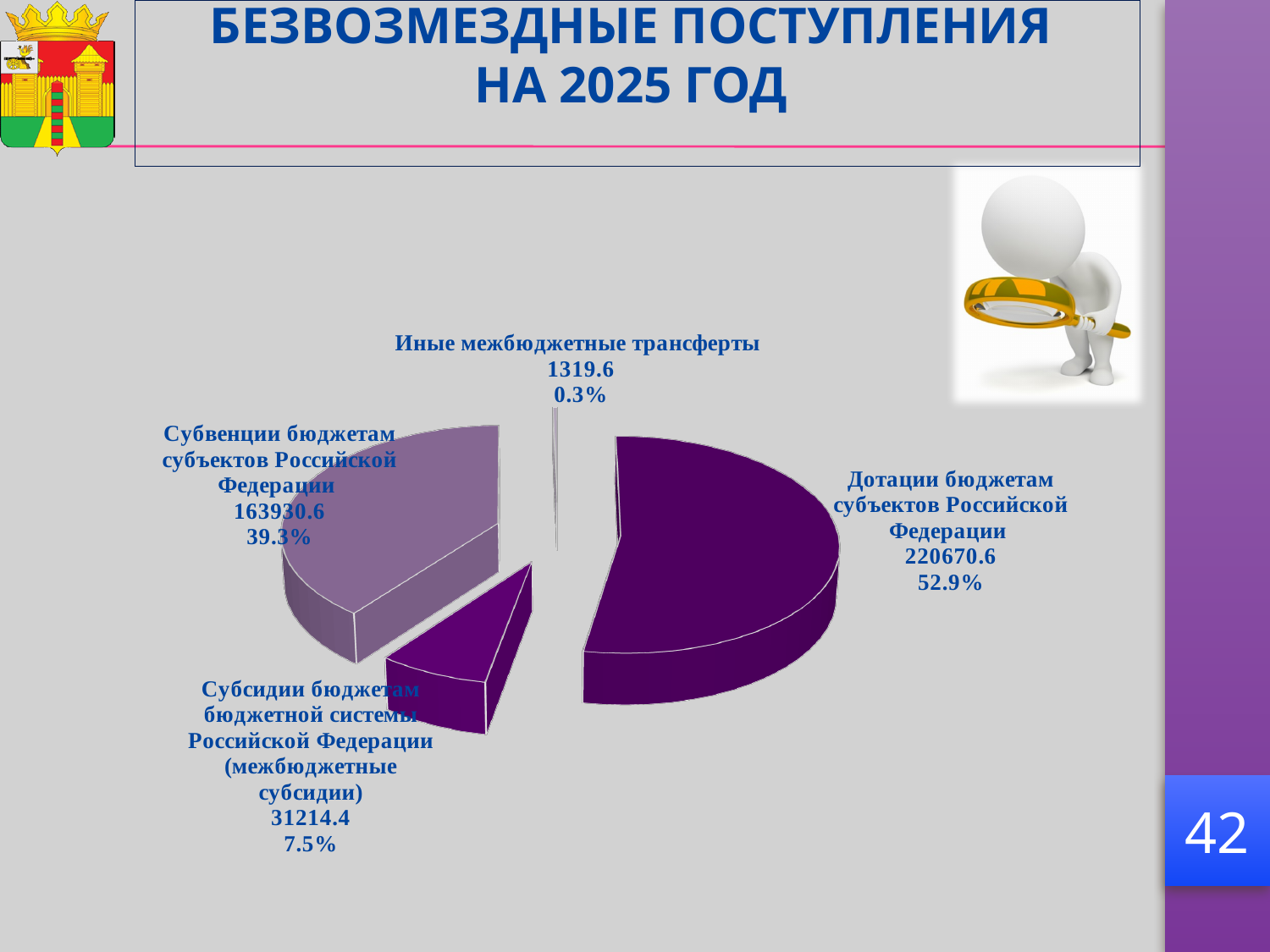
What is the title of the slide containing the chart? БЕЗВОЗМЕЗДНЫЕ ПОСТУПЛЕНИЯ НА 2025 ГОД How many slices does the pie chart have? 4 Which is larger: Субсидии бюджетам бюджетной системы Российской Федерации (межбюджетные субсидии) or Иные межбюджетные трансферты? Субсидии бюджетам бюджетной системы Российской Федерации (межбюджетные субсидии) Which category has the smallest slice? Иные межбюджетные трансферты What share of the pie is Дотации бюджетам субъектов Российской Федерации? 52.9% What share of the pie is Иные межбюджетные трансферты? 0.3% What is the value for Дотации бюджетам субъектов Российской Федерации? 220670.6 What type of chart is shown on the slide? pie chart What share of the pie is Субвенции бюджетам субъектов Российской Федерации? 39.3% Which category has the largest slice? Дотации бюджетам субъектов Российской Федерации What is the difference between the values for Дотации бюджетам субъектов Российской Федерации and Субвенции бюджетам субъектов Российской Федерации? 56740.0 What is the value for Субсидии бюджетам бюджетной системы Российской Федерации (межбюджетные субсидии)? 31214.4